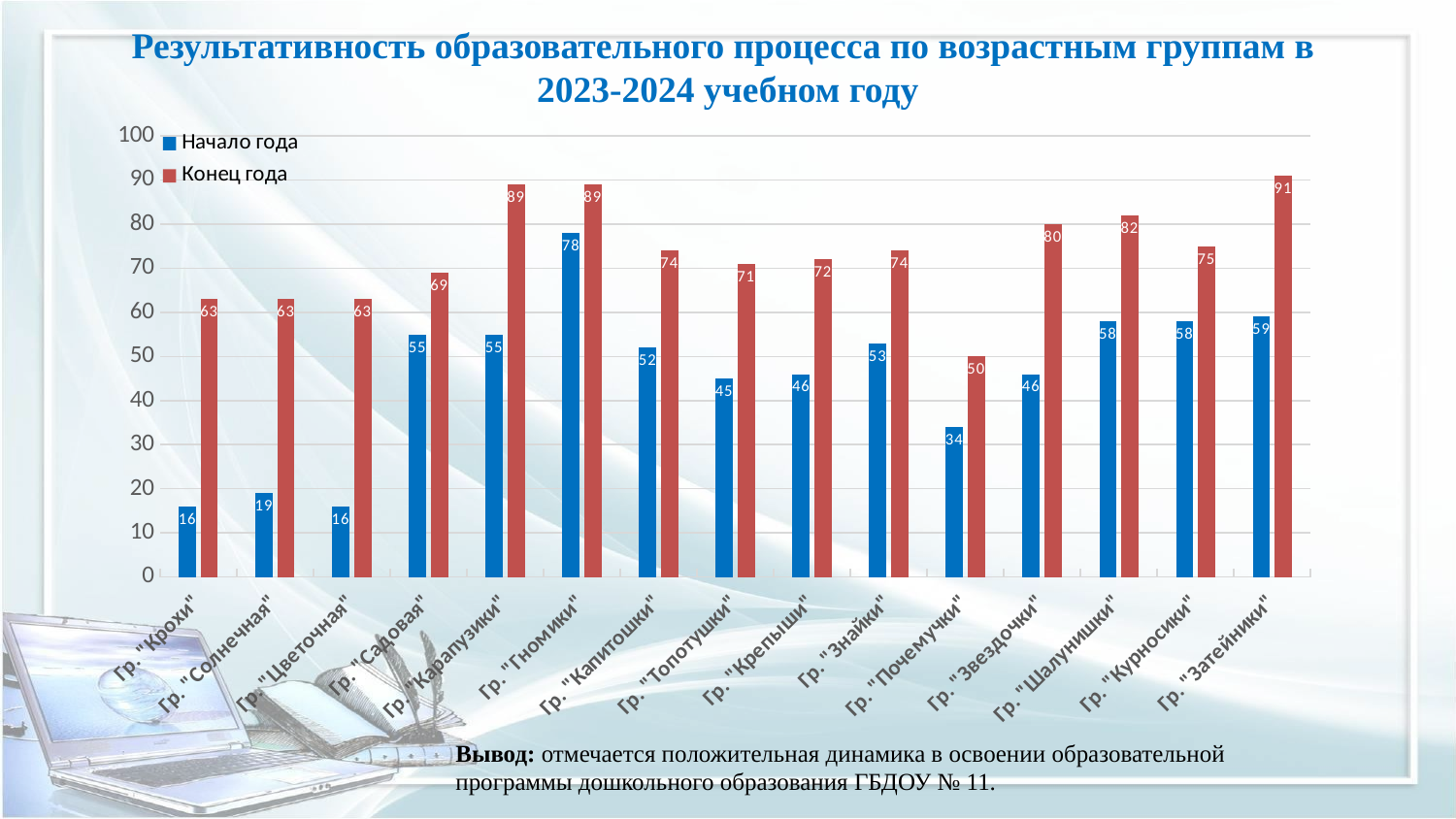
What type of chart is shown on the slide? bar chart How many series does the legend list? 2 What is the value for Гр. "Гномики" in the series Начало года? 78 Which series is shown in red in the legend? Конец года Which group has the lowest value in the series Конец года? Гр. "Почемучки" What is the value for Гр. "Звездочки" in the series Начало года? 46 Which group has the highest value in the series Начало года? Гр. "Гномики" Which group has the highest value in the series Конец года? Гр. "Затейники" How many groups (categories) are shown on the x axis? 15 What is the value for Гр. "Почемучки" in the series Конец года? 50 What is the difference between the Конец года and Начало года values for Гр. "Крохи"? 47 Which is larger: the Конец года value for Гр. "Шалунишки" or for Гр. "Курносики"? Гр. "Шалунишки"